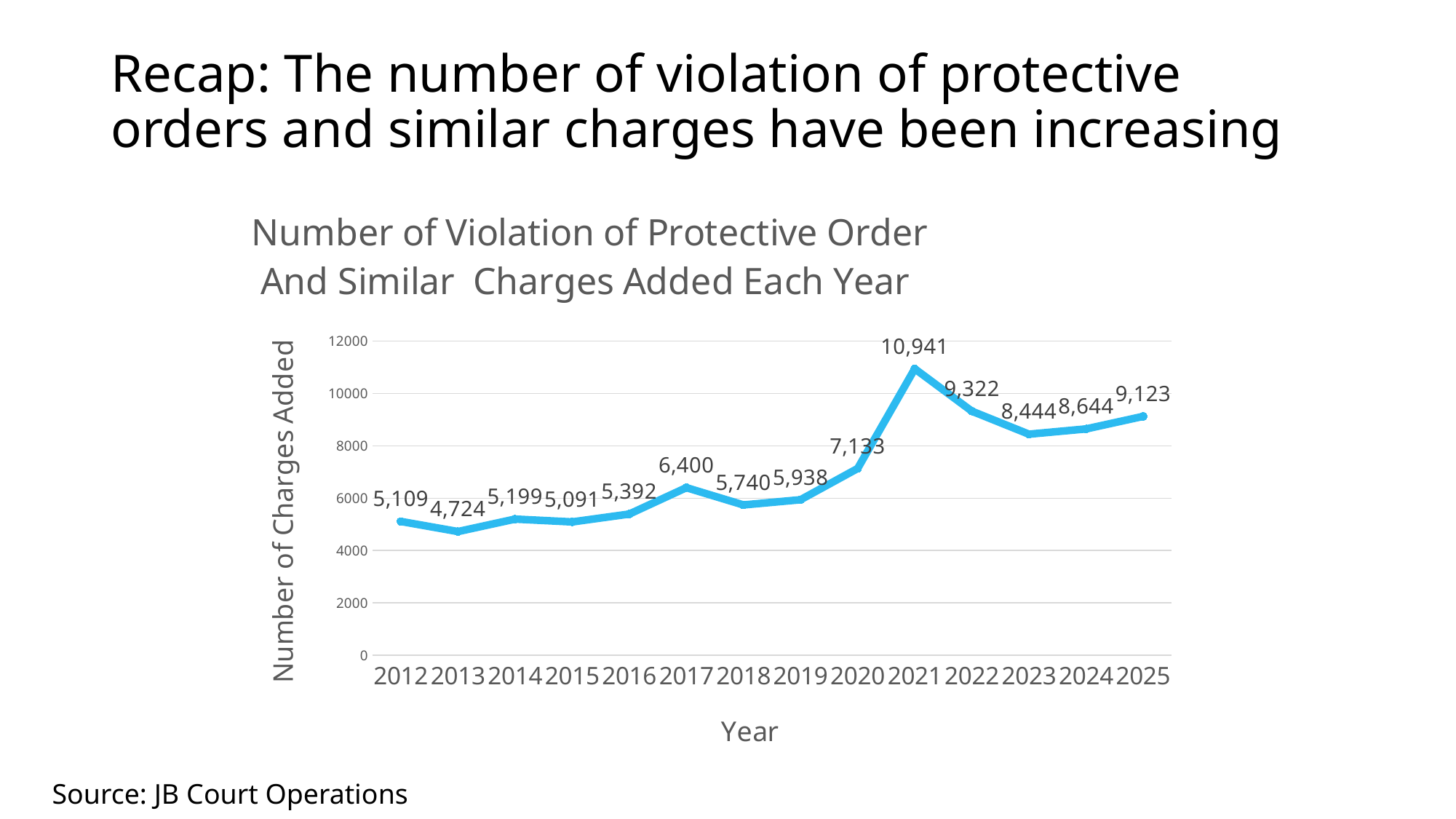
How many years are plotted on the x axis? 14 What is the number of charges added in 2025? 9,123 What is the difference between the number of charges added in 2021 and in 2022? 1,619 Is the value for 2020 greater or less than 8000? less Do the values generally rise or fall from 2012 to 2025? rise What is the number of charges added in 2013? 4,724 Which year has more charges added, 2017 or 2018? 2017 Which year has the lowest number of charges added? 2013 What is the label of the y axis? Number of Charges Added Which year has the highest number of charges added? 2021 What kind of chart is shown on the slide? line chart What is the number of charges added in 2021? 10,941